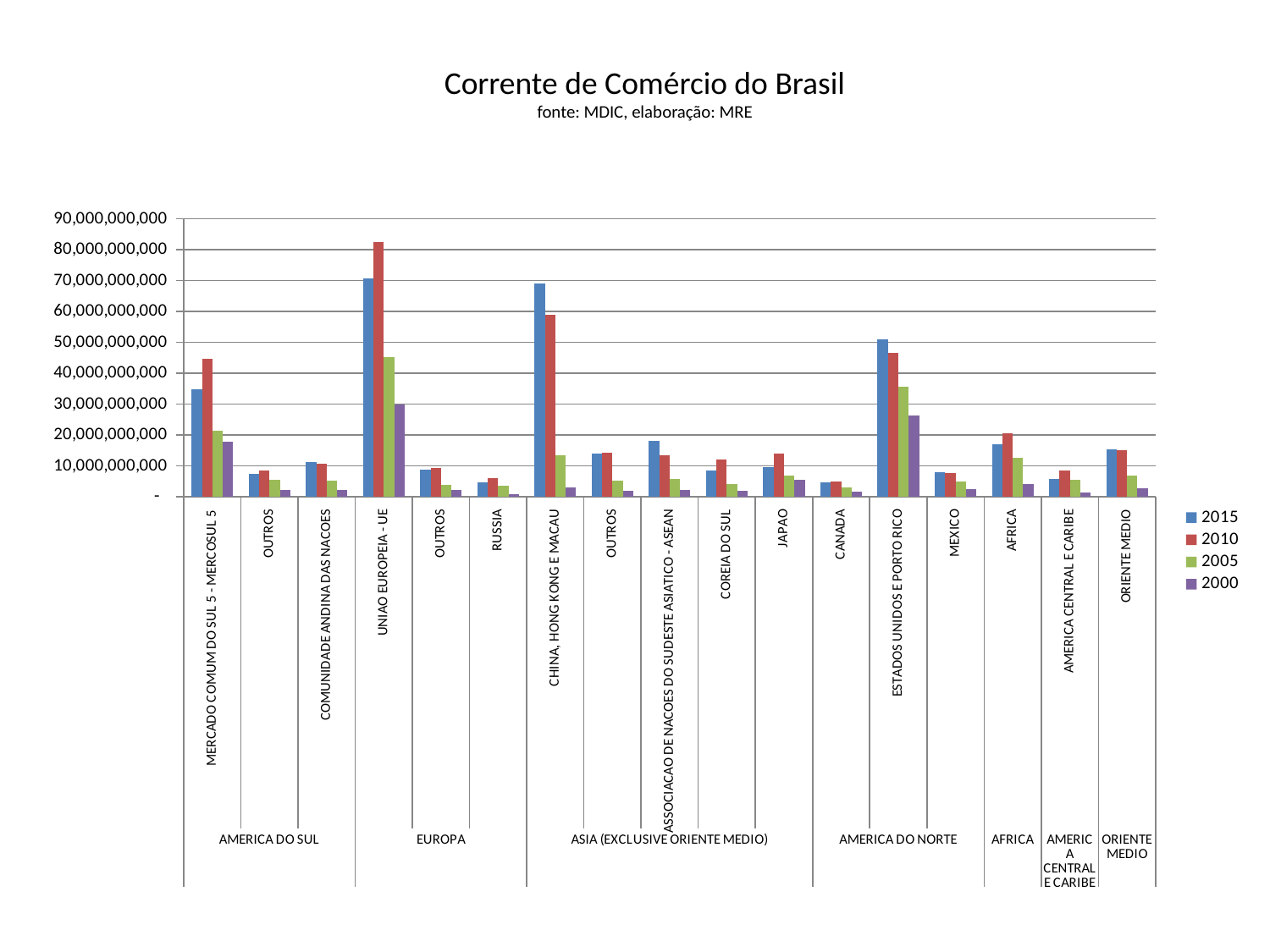
For CHINA, HONG KONG E MACAU, which is larger: the 2015 value or the 2010 value? 2015 For ESTADOS UNIDOS E PORTO RICO, do the values rise or fall from 2000 to 2015? rise Is the 2015 value for RUSSIA greater or less than 10,000,000,000? less Is the 2010 value for MERCADO COMUM DO SUL 5 - MERCOSUL 5 greater or less than 40,000,000,000? greater What kind of chart is shown on the slide? bar chart How many sub-categories (partners) are plotted along the x axis? 17 Is the 2015 value for CHINA, HONG KONG E MACAU greater or less than 60,000,000,000? greater For JAPAO, which is larger: the 2010 value or the 2015 value? 2010 Which partner has the tallest bar in the chart? UNIAO EUROPEIA - UE What is the title of the chart? Corrente de Comércio do Brasil How many series does the legend list? 4